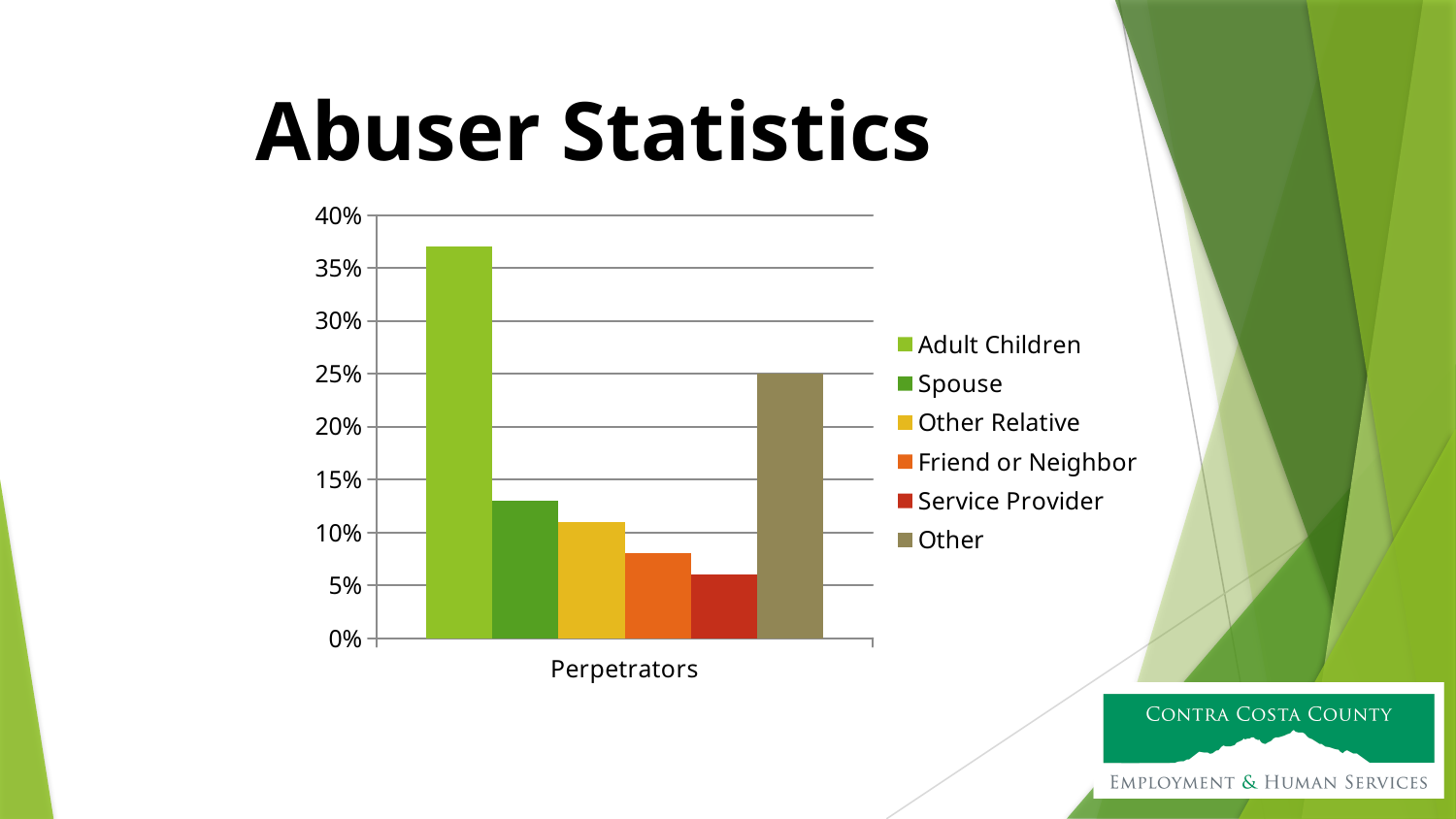
How many bars are plotted in the chart? 6 Is the value for Friend or Neighbor greater or less than 10%? less What kind of chart is shown on the slide? bar chart Which category has the lowest value? Service Provider Is the value for Service Provider greater or less than 10%? less Is the value for Spouse greater or less than 10%? greater What is the title of the chart's x axis? Perpetrators Which is larger, the value for Other or the value for Spouse? Other Which category has the highest value? Adult Children How many series does the legend list? 6